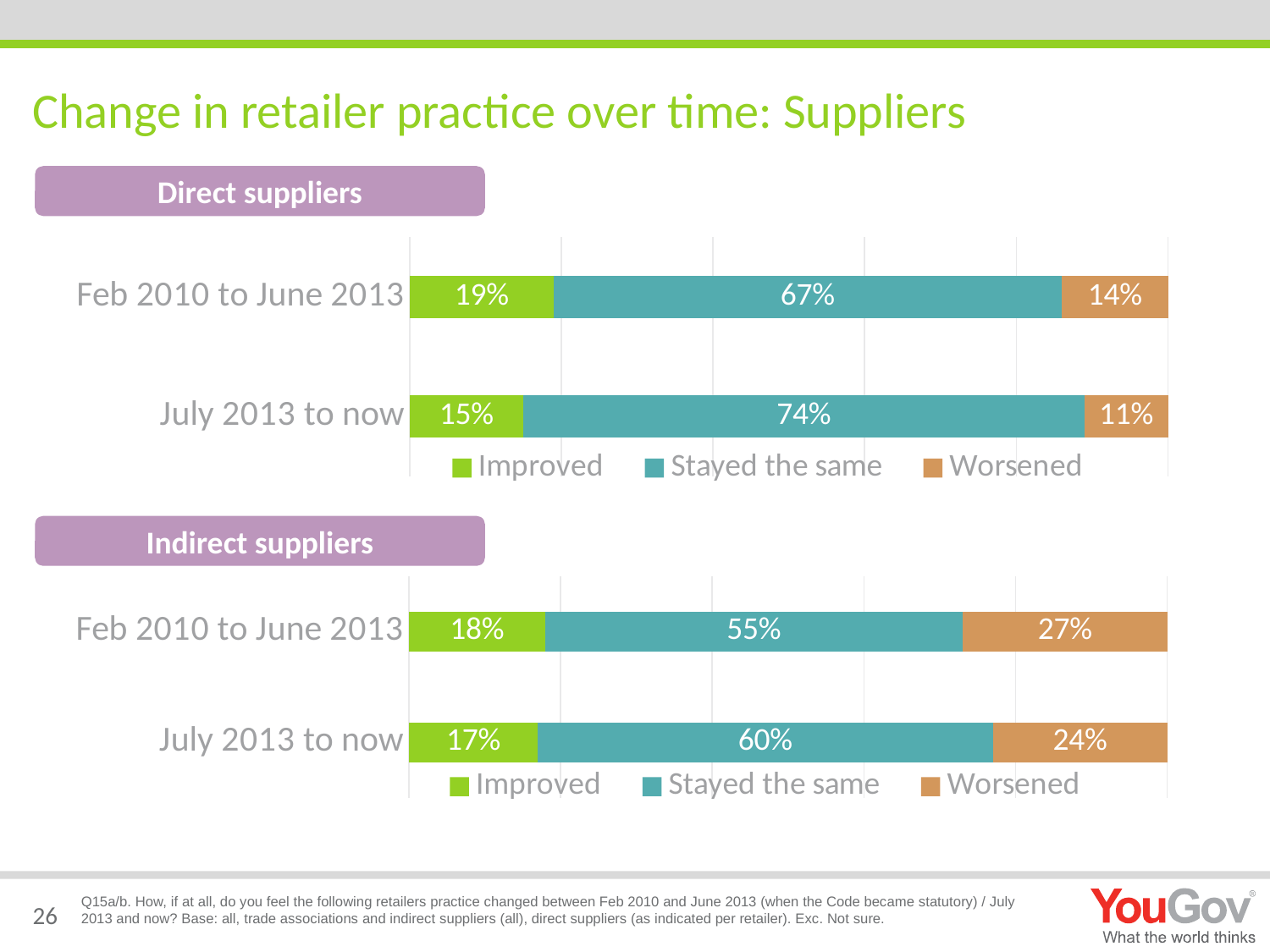
In the Direct suppliers chart, what percentage said retailer practice stayed the same from July 2013 to now? 74% What kind of chart is the Direct suppliers chart? Stacked bar chart In the Direct suppliers chart, what percentage said retailer practice improved from Feb 2010 to June 2013? 19% In the Indirect suppliers chart, which period has the larger Worsened value, Feb 2010 to June 2013 or July 2013 to now? Feb 2010 to June 2013 In the Indirect suppliers chart, what is the total of the Feb 2010 to June 2013 bar? 100% How many time periods are shown in the Indirect suppliers chart? 2 In the Indirect suppliers chart, what is the difference between the Stayed the same values for July 2013 to now and Feb 2010 to June 2013? 5% In the Indirect suppliers chart, what percentage said retailer practice improved from July 2013 to now? 17% In the Direct suppliers chart, what is the difference between the Worsened values for Feb 2010 to June 2013 and July 2013 to now? 3% How many series does the legend of the Direct suppliers chart list? 3 In the Indirect suppliers chart, what percentage said retailer practice worsened from Feb 2010 to June 2013? 27% In the Direct suppliers chart, which segment is largest for the July 2013 to now bar? Stayed the same